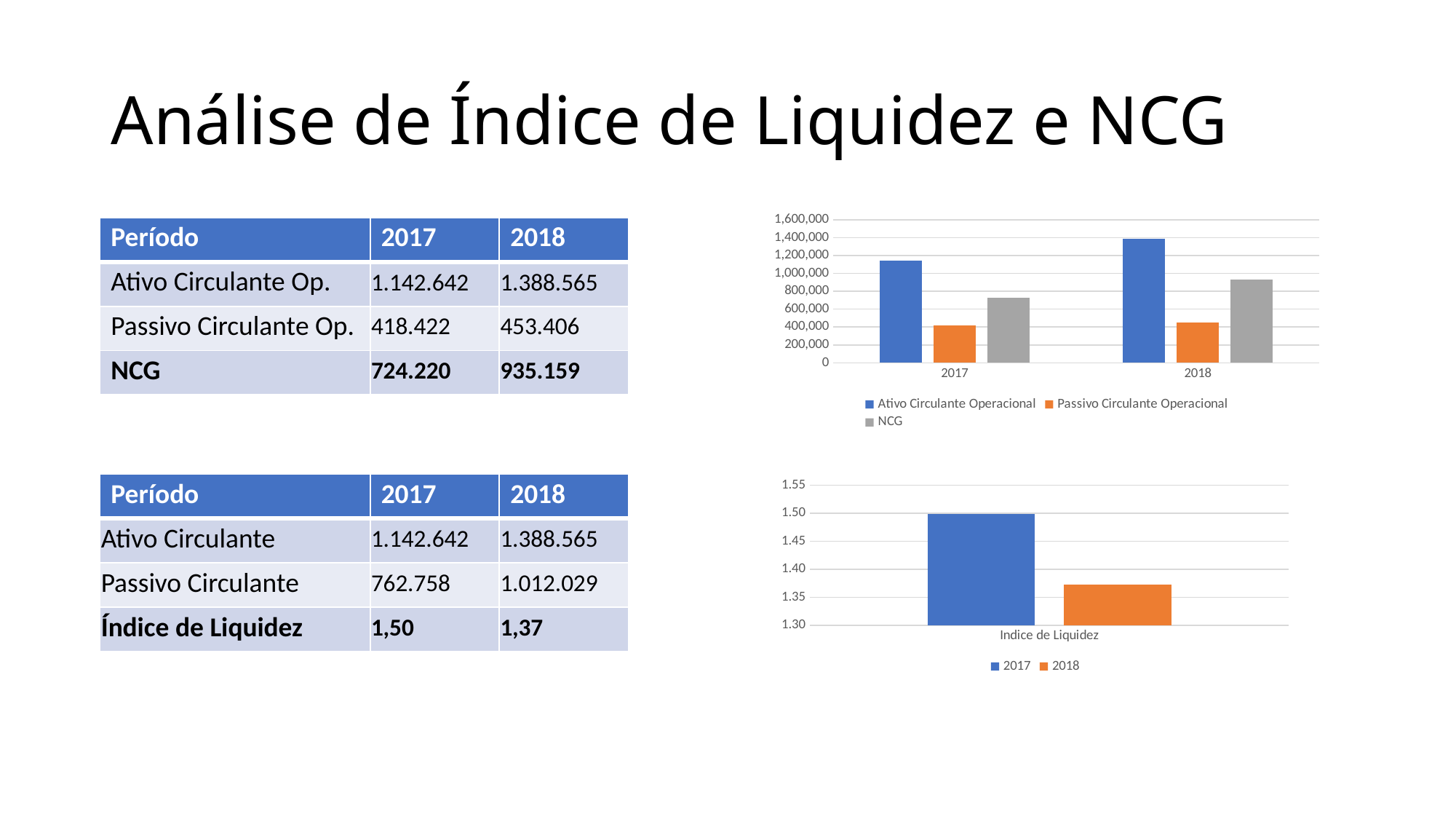
In the top-right chart, does the Passivo Circulante Operacional value rise or fall from 2017 to 2018? rises In the top-right chart, is the NCG value for 2018 greater or less than 800,000? greater In the bottom-right chart (Indice de Liquidez), how many series does the legend list? 2 What kind of chart is the top-right chart on the slide? bar chart In the top-right chart, which series has the lowest bar for 2017? Passivo Circulante Operacional In the top-right chart, how many year categories are shown on the x axis? 2 In the bottom-right chart (Indice de Liquidez), which year has the larger value, 2017 or 2018? 2017 In the top-right chart, which series has the highest bar for 2018? Ativo Circulante Operacional In the top-right chart, how many series does the legend list? 3 In the top-right chart, is the NCG bar larger for 2017 or 2018? 2018 In the bottom-right chart (Indice de Liquidez), is the value for 2018 greater or less than 1.40? less In the top-right chart, is the Ativo Circulante Operacional value for 2017 greater or less than 1,000,000? greater